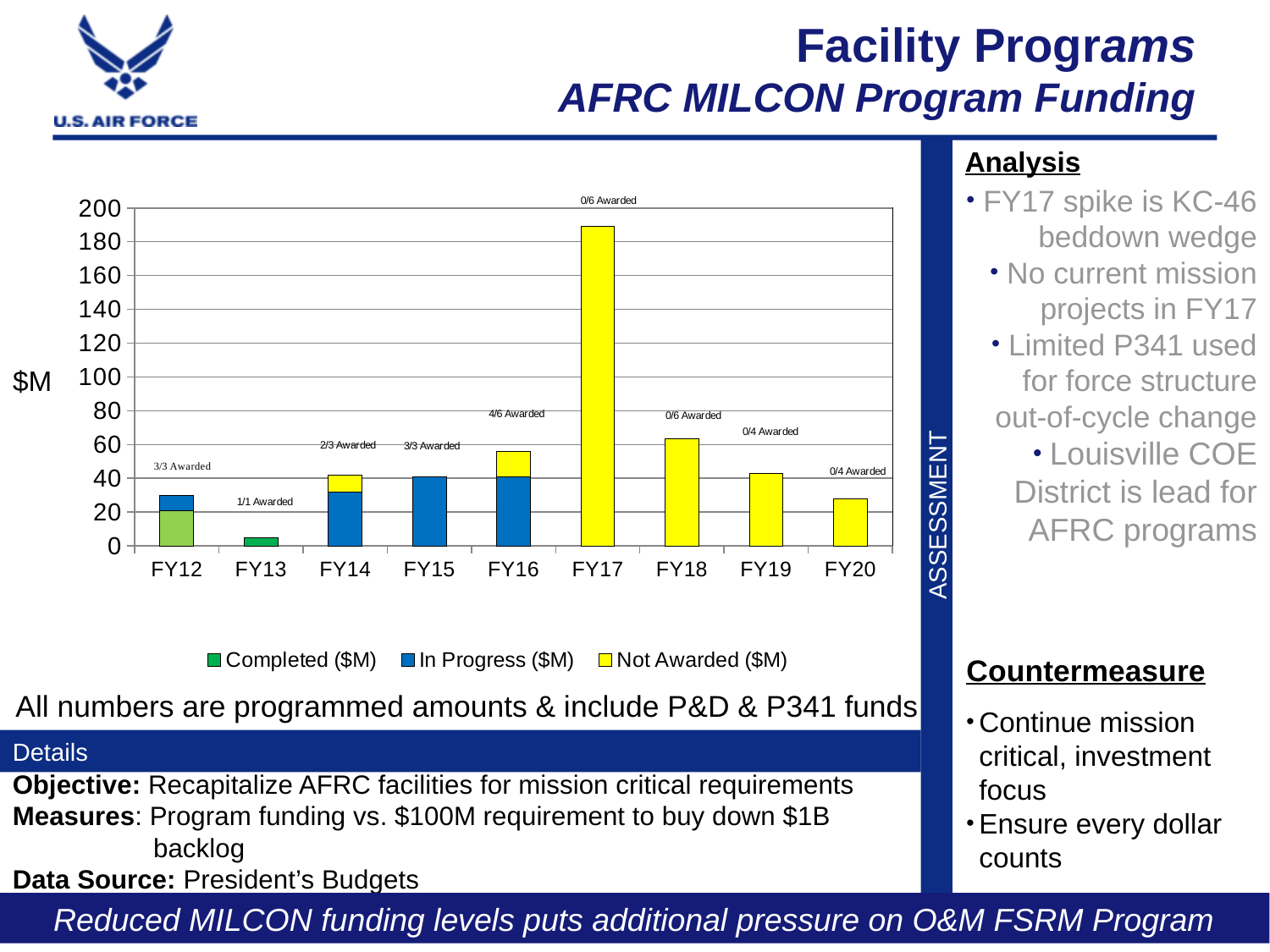
How many series does the chart legend list? 3 Is the total value for FY17 greater or less than 180? greater How many fiscal years are shown on the x axis of the chart? 9 What awarded label is printed above the FY17 bar? 0/6 Awarded Is the total value for FY13 greater or less than 20? less What kind of chart is shown on the slide? Stacked bar chart Which fiscal year has the lowest total bar in the chart? FY13 Which has the larger total bar, FY17 or FY18? FY17 Which fiscal year has the highest total bar in the chart? FY17 Is the total value for FY18 greater or less than 40? greater What awarded label is printed above the FY16 bar? 4/6 Awarded What unit label is shown on the y axis of the chart? $M